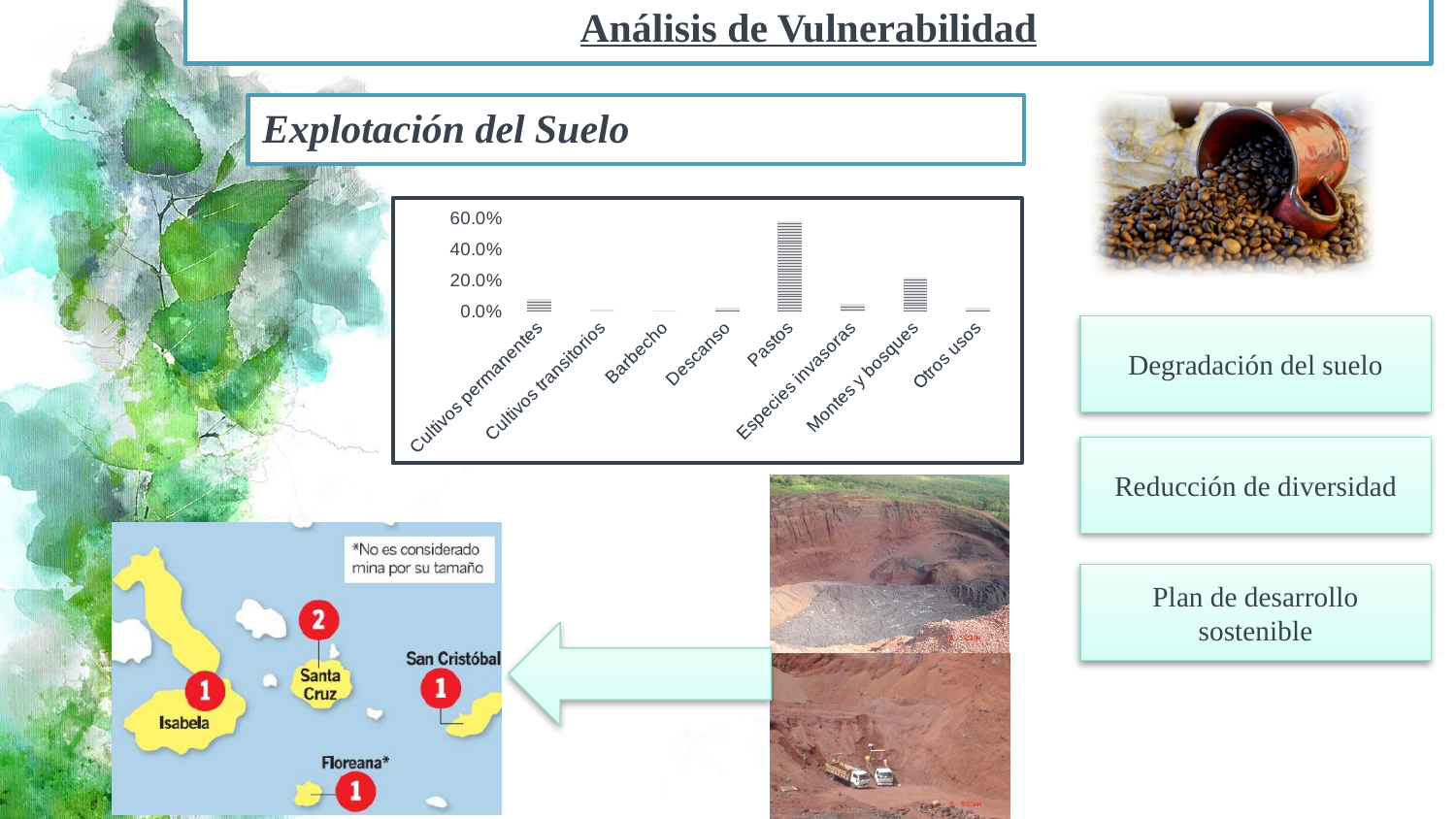
Is the value for Especies invasoras greater or less than 20.0%? less Is the value for Cultivos permanentes greater or less than 20.0%? less Is the value for Pastos greater or less than 40.0%? greater Which is larger, the value for Pastos or the value for Montes y bosques? Pastos How many categories are shown on the x axis of the chart? 8 What kind of chart is shown on the slide? bar chart Which is larger, the value for Montes y bosques or the value for Cultivos permanentes? Montes y bosques Which is larger, the value for Cultivos permanentes or the value for Barbecho? Cultivos permanentes Which category appears second from the right on the x axis of the chart? Montes y bosques What is the highest value shown on the y axis of the chart? 60.0% Which category has the highest value in the chart? Pastos